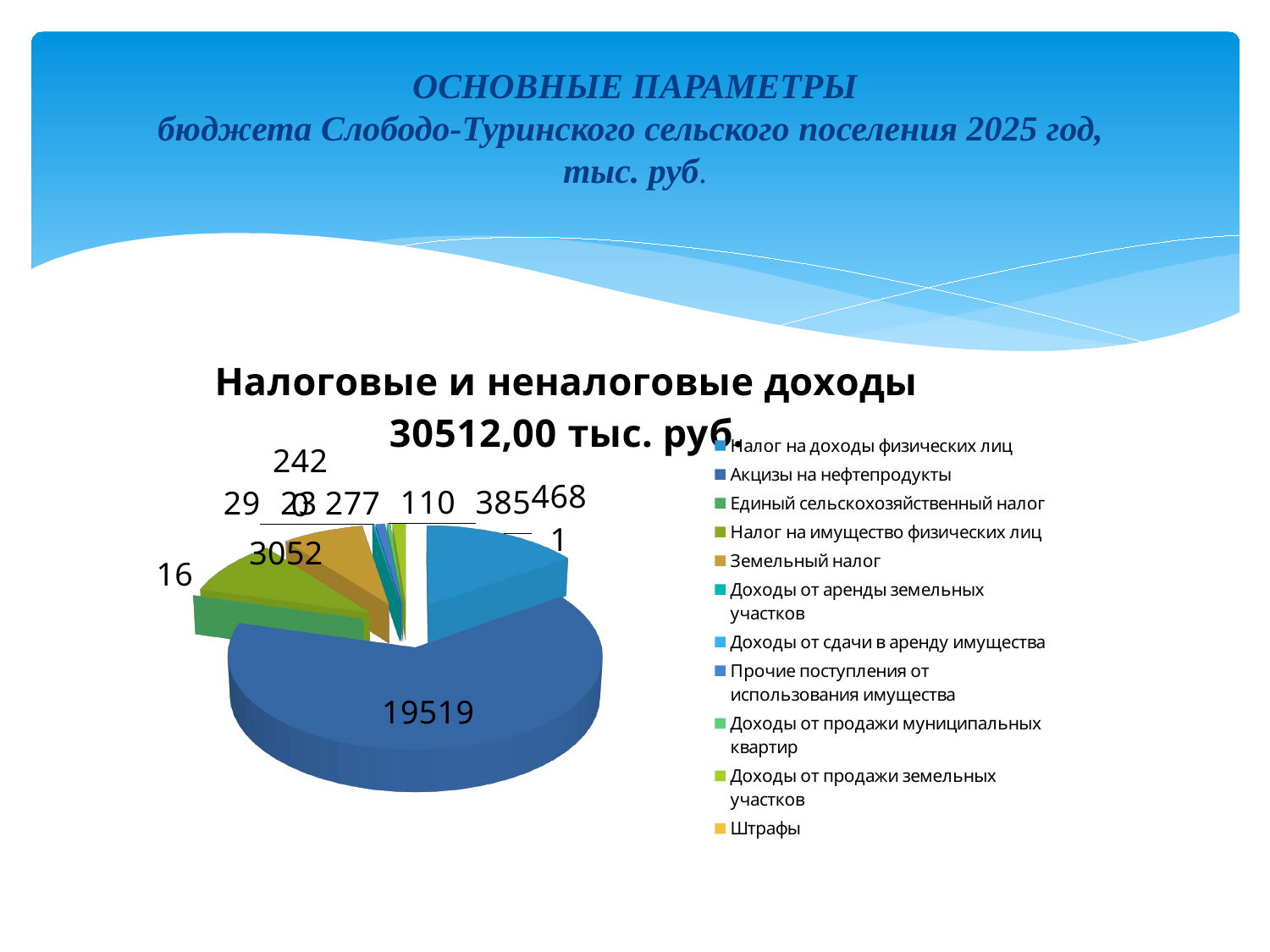
What is the difference between the slices labelled 19519 and 3052? 16467 What is the largest value labelled on the pie chart? 19519 Which is larger: the slice labelled 468 or the slice labelled 385? 468 What is the title of the pie chart? Налоговые и неналоговые доходы 30512,00 тыс. руб. What kind of chart is shown on the slide? pie chart How many entries does the legend of the pie chart list? 11 Which category does the largest slice of the pie chart (labelled 19519) belong to? Акцизы на нефтепродукты What total amount of tax and non-tax revenue is stated in the chart title? 30512,00 тыс. руб. What is the last entry in the pie chart's legend? Штрафы